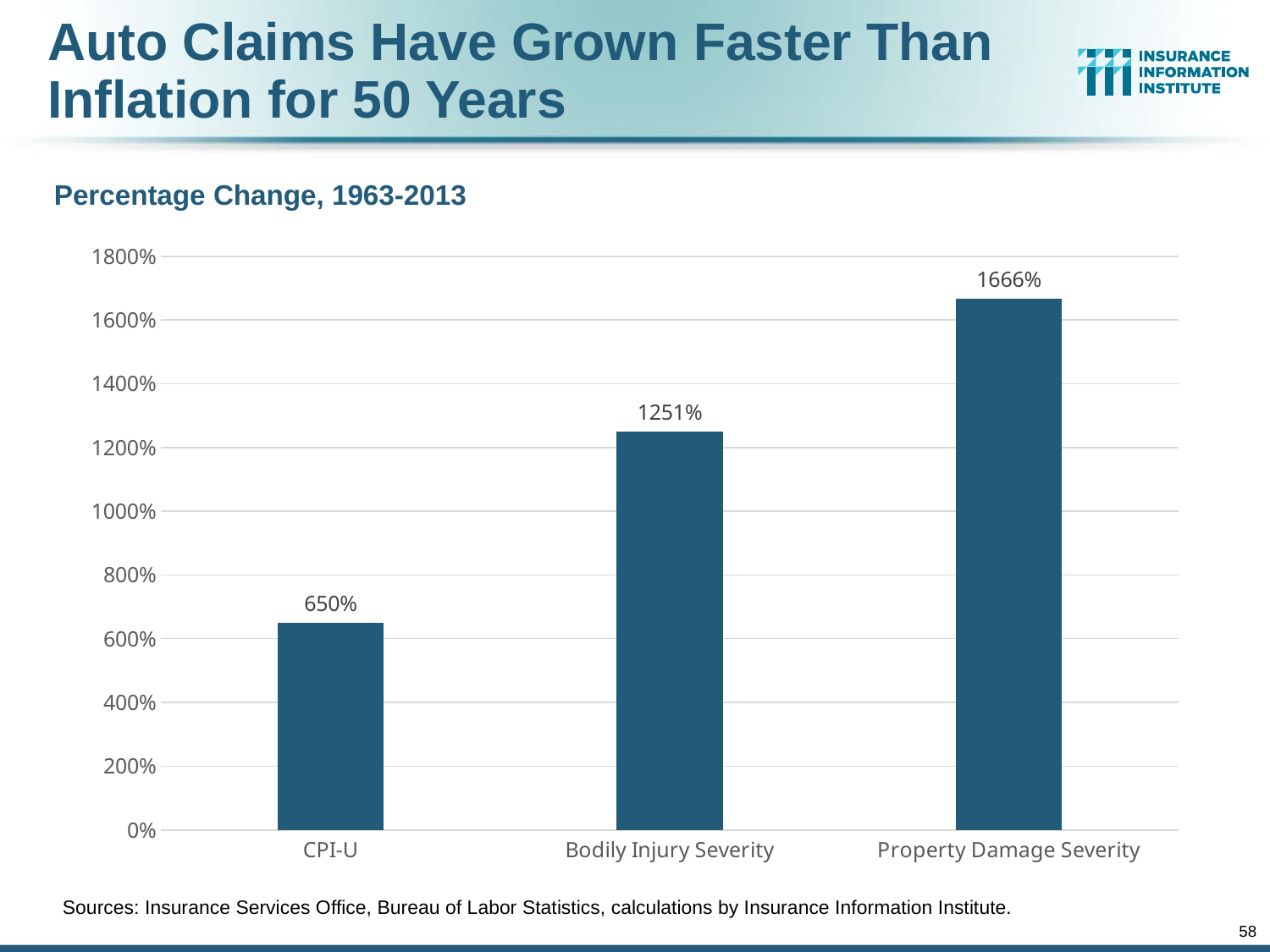
What is the percentage change for CPI-U? 650% What kind of chart is shown on the slide? Bar chart Which category has the lowest percentage change? CPI-U Which category has the highest percentage change? Property Damage Severity What is the percentage change for Property Damage Severity? 1666% Which is larger, the percentage change for Bodily Injury Severity or for CPI-U? Bodily Injury Severity What is the difference in percentage change between Property Damage Severity and CPI-U? 1016% What is the percentage change for Bodily Injury Severity? 1251% What is the difference in percentage change between Bodily Injury Severity and CPI-U? 601% What is the subtitle of the chart? Percentage Change, 1963-2013 How many categories are shown on the chart? 3 Is the value for Bodily Injury Severity greater or less than 1400%? less